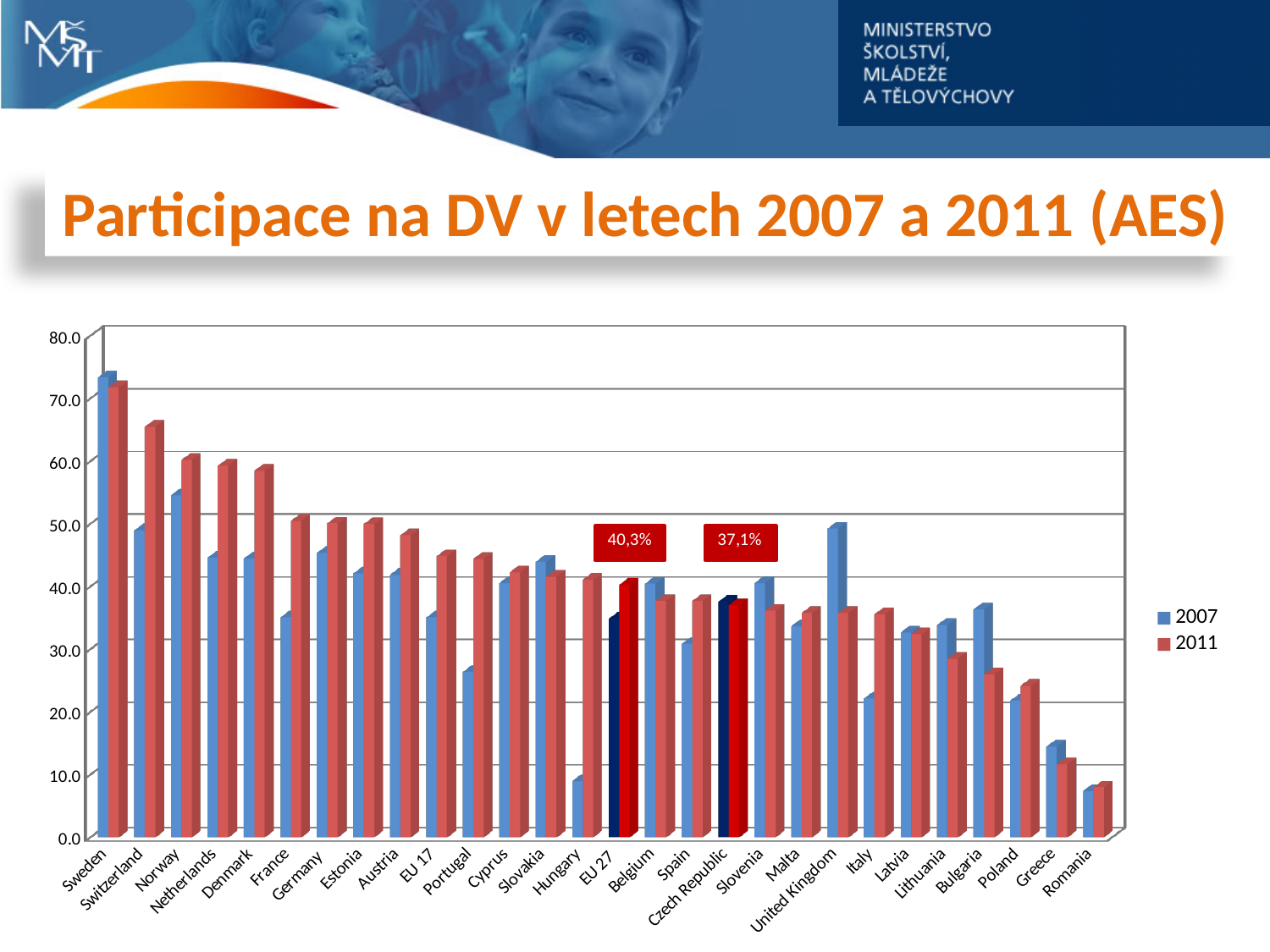
How many countries or groups are shown on the x axis? 28 What is the labelled 2011 value for EU 27? 40,3% Which country has the highest 2007 value? Sweden How many series does the legend list? 2 Do the 2011 values generally rise or fall from left to right along the x axis? fall Is the 2007 value for Portugal greater or less than 30.0? less What kind of chart is shown on the slide? bar chart What is the difference between the labelled 2011 values for EU 27 and the Czech Republic? 3,2% What is the labelled 2011 value for the Czech Republic? 37,1% Is the 2011 value for Switzerland greater or less than 60.0? greater For Hungary, which is larger: the 2007 value or the 2011 value? 2011 Which country has the lowest 2011 value? Romania